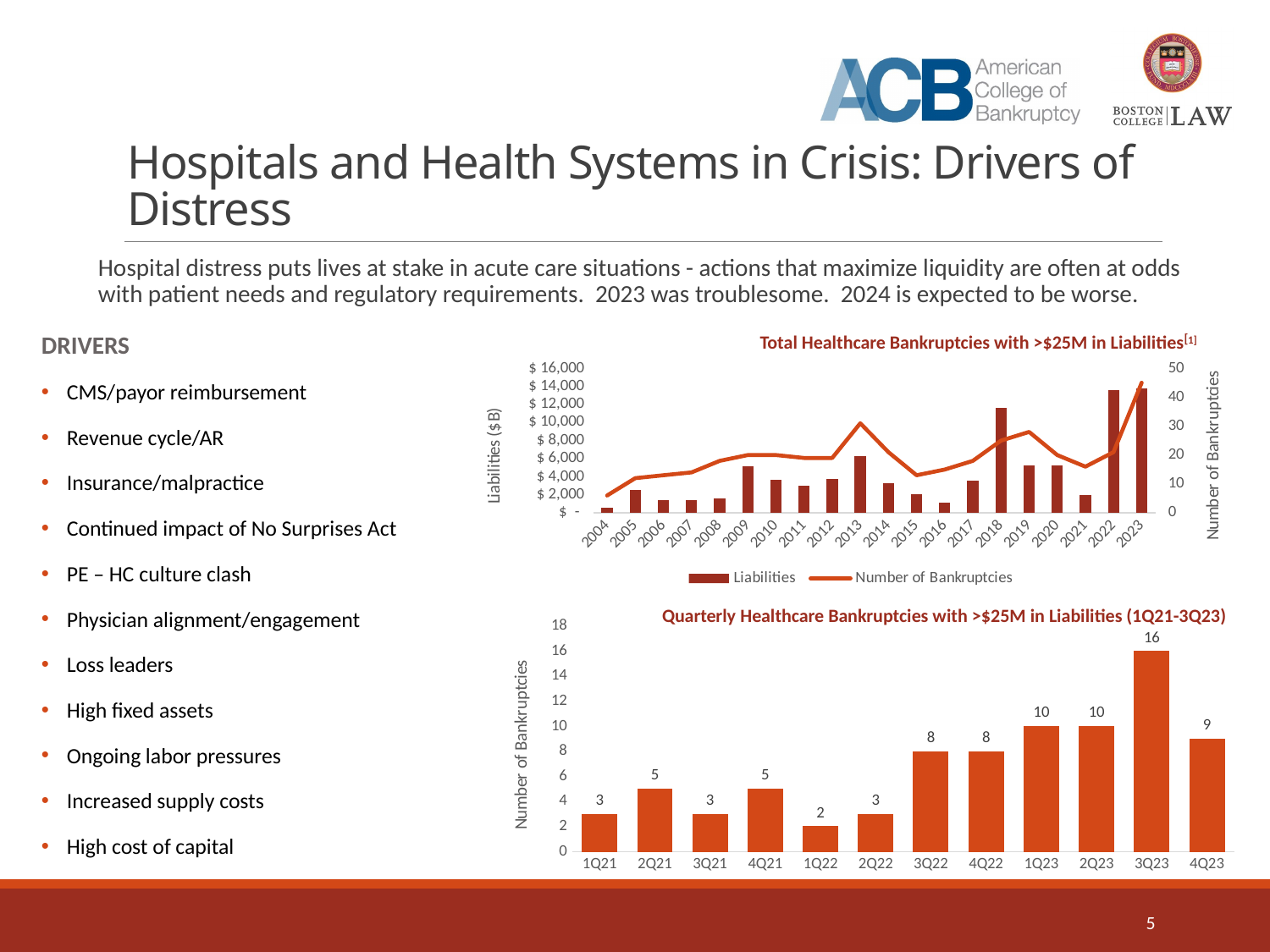
What kind of chart is the Quarterly Healthcare Bankruptcies chart? Bar chart In the Quarterly Healthcare Bankruptcies chart, what is the difference between the values for 3Q23 and 4Q23? 7 In the Quarterly Healthcare Bankruptcies chart, which quarter has the lowest number of bankruptcies? 1Q22 In the Total Healthcare Bankruptcies chart, is the Number of Bankruptcies for 2023 greater or less than 40? greater In the Quarterly Healthcare Bankruptcies chart, what is the value for 3Q23? 16 How many series does the legend of the Total Healthcare Bankruptcies chart list? 2 In the Total Healthcare Bankruptcies chart, is the Liabilities value for 2022 greater or less than $12,000? greater In the Quarterly Healthcare Bankruptcies chart, which is larger, the value for 1Q23 or the value for 4Q23? 1Q23 How many quarters are shown in the Quarterly Healthcare Bankruptcies chart? 12 How many years are shown on the x axis of the Total Healthcare Bankruptcies chart? 20 In the Quarterly Healthcare Bankruptcies chart, which quarter has the highest number of bankruptcies? 3Q23 In the Quarterly Healthcare Bankruptcies chart, what is the value for 1Q22? 2